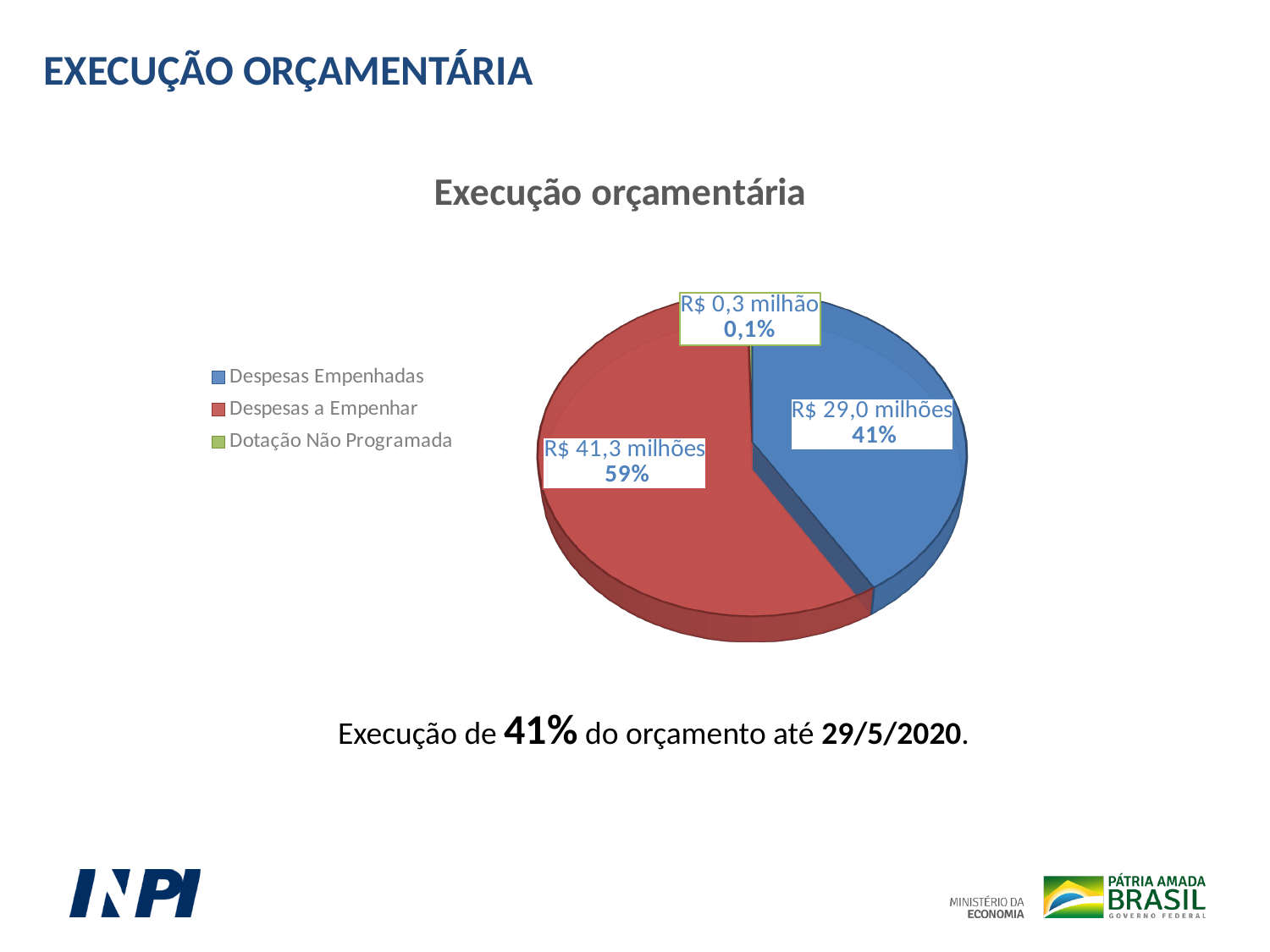
What is the value shown for Despesas a Empenhar? R$ 41,3 milhões What kind of chart is shown on the slide? pie chart What is the value shown for Despesas Empenhadas? R$ 29,0 milhões What share of the pie does Despesas a Empenhar represent? 59% How many series does the legend list? 3 What is the value shown for Dotação Não Programada? R$ 0,3 milhão Which category has the smallest slice of the pie? Dotação Não Programada What share of the pie does Dotação Não Programada represent? 0,1% What is the title of the chart? Execução orçamentária What share of the pie does Despesas Empenhadas represent? 41% Which is larger, Despesas Empenhadas or Despesas a Empenhar? Despesas a Empenhar Which category has the largest slice of the pie? Despesas a Empenhar